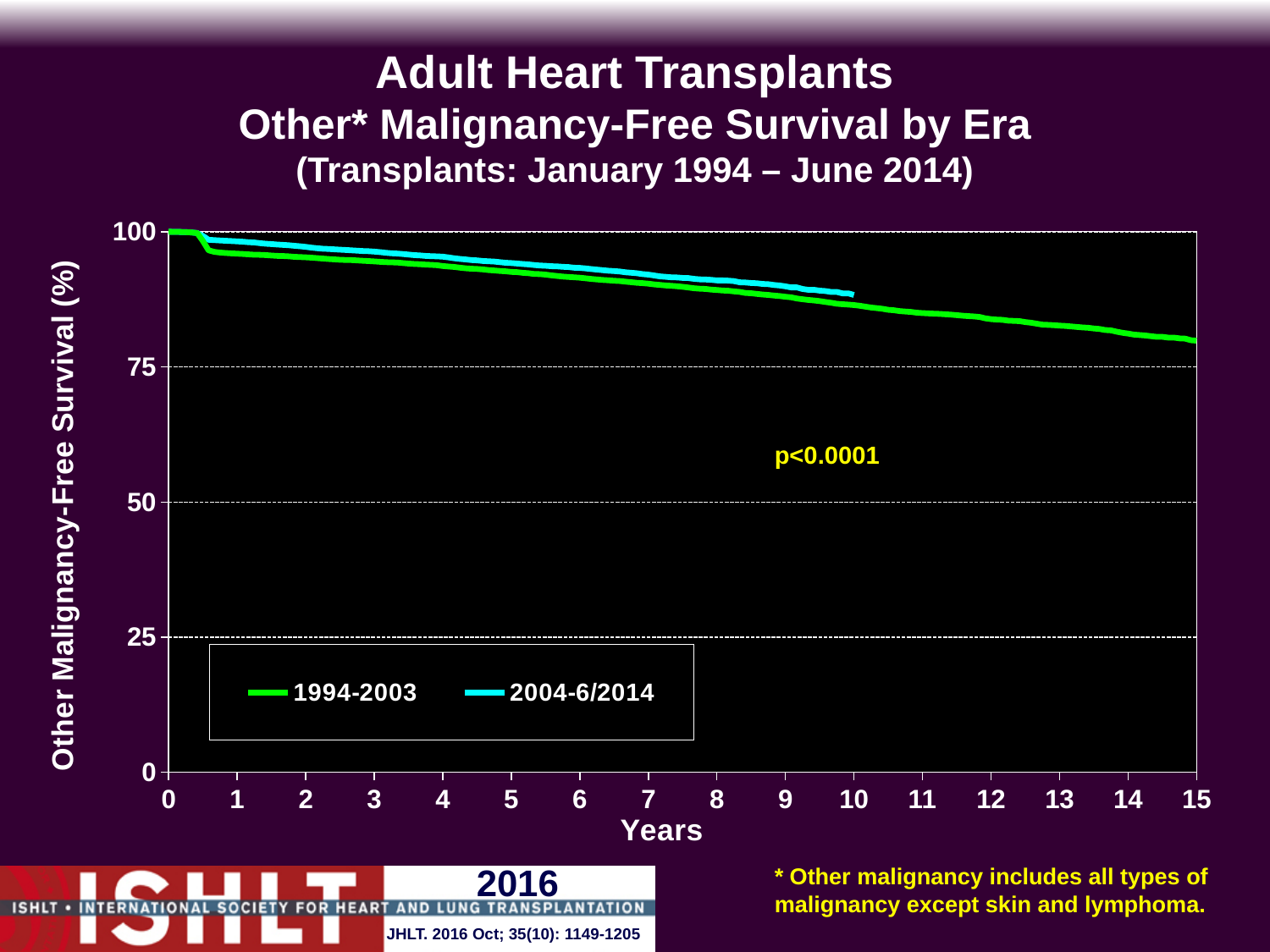
What is the highest value shown on the y axis? 100 Is the value for the 1994-2003 series at 15 years greater or less than 75? greater Which series extends to 15 years on the x axis? 1994-2003 How many series does the legend list? 2 What is the label of the y axis? Other Malignancy-Free Survival (%) Do the survival values rise or fall as years increase? fall Is the value for the 1994-2003 series at 10 years greater or less than 100? less What kind of chart is shown on the slide? line chart At 5 years, which series has the higher survival value, 1994-2003 or 2004-6/2014? 2004-6/2014 Is the value for the 2004-6/2014 series at 10 years greater or less than 75? greater